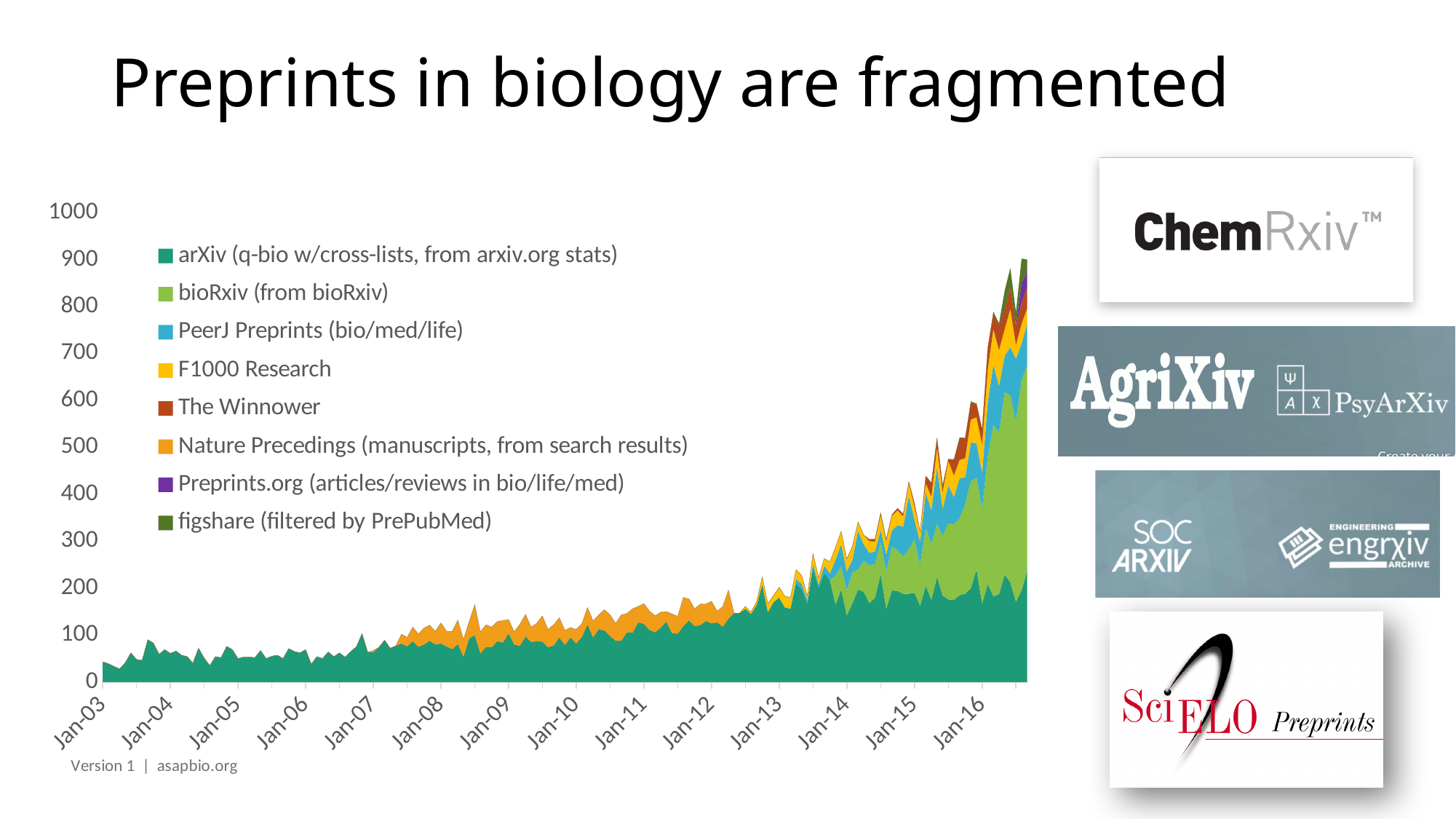
Is the highest stacked total on the chart (near the right end) greater or less than 800? greater What is the title of the slide containing the chart? Preprints in biology are fragmented What kind of chart is shown on the slide? stacked area chart Is the stacked total at Jan-15 greater or less than 200? greater Is the stacked total at Jan-10 greater or less than 300? less Which series occupies the bottom layer of the stacked area chart? arXiv (q-bio w/cross-lists, from arxiv.org stats) Which series is listed first in the chart's legend? arXiv (q-bio w/cross-lists, from arxiv.org stats) How many series does the chart's legend list? 8 Overall, do the stacked totals rise or fall from Jan-03 to the end of the x axis? rise